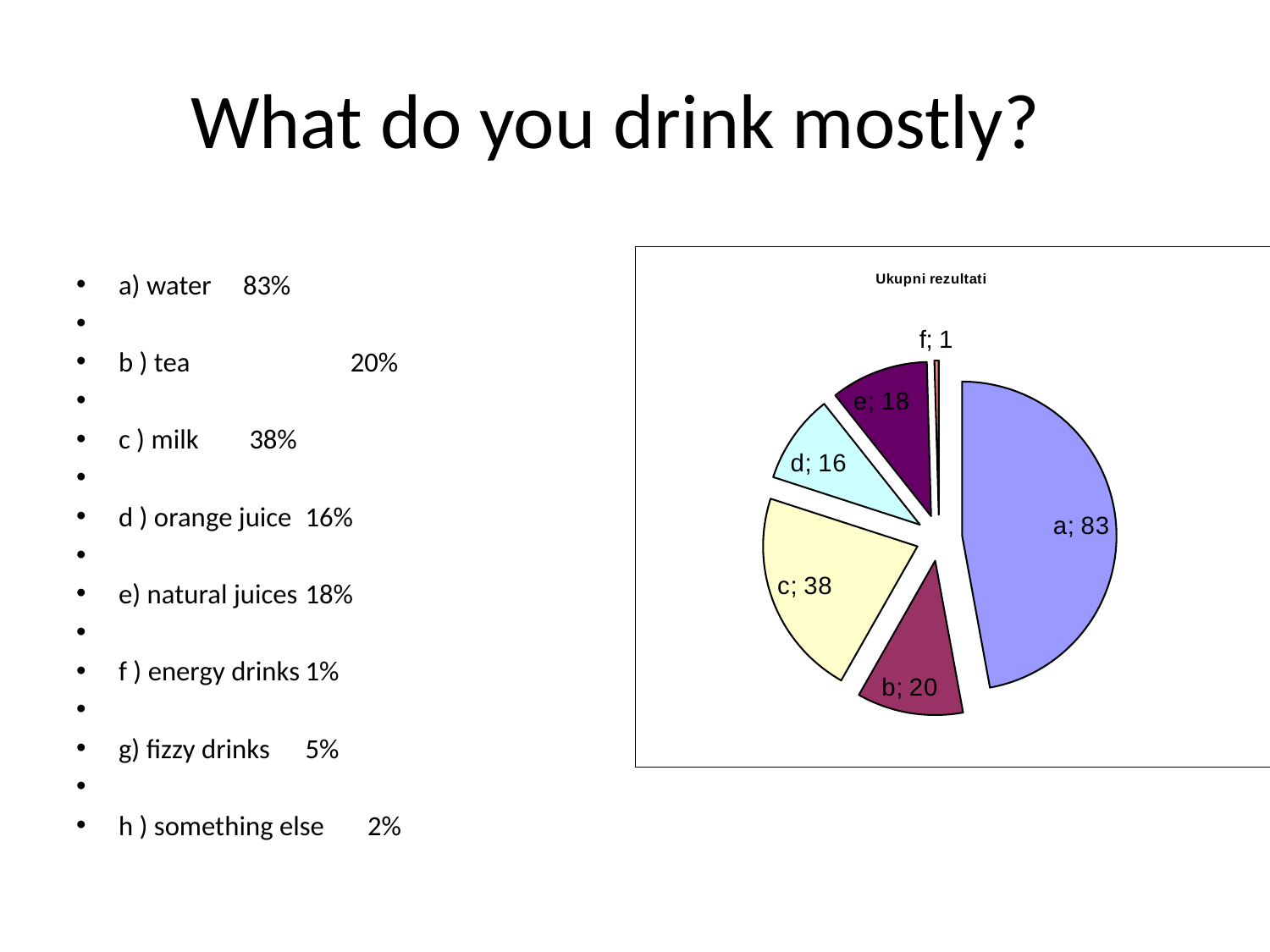
Which slice has the larger value in the pie chart, d or e? e What is the value shown for slice a in the pie chart? 83 Which labelled slice of the pie chart has the smallest value? f What is the difference between the values of slices a and b in the pie chart? 63 What is the value shown for slice d in the pie chart? 16 Which slice has the larger value in the pie chart, b or c? c Which labelled slice of the pie chart has the largest value? a What is the difference between the values of slices c and b in the pie chart? 18 What is the value shown for slice f in the pie chart? 1 What is the title of the pie chart? Ukupni rezultati What is the value shown for slice c in the pie chart? 38 What kind of chart is shown on the slide? pie chart